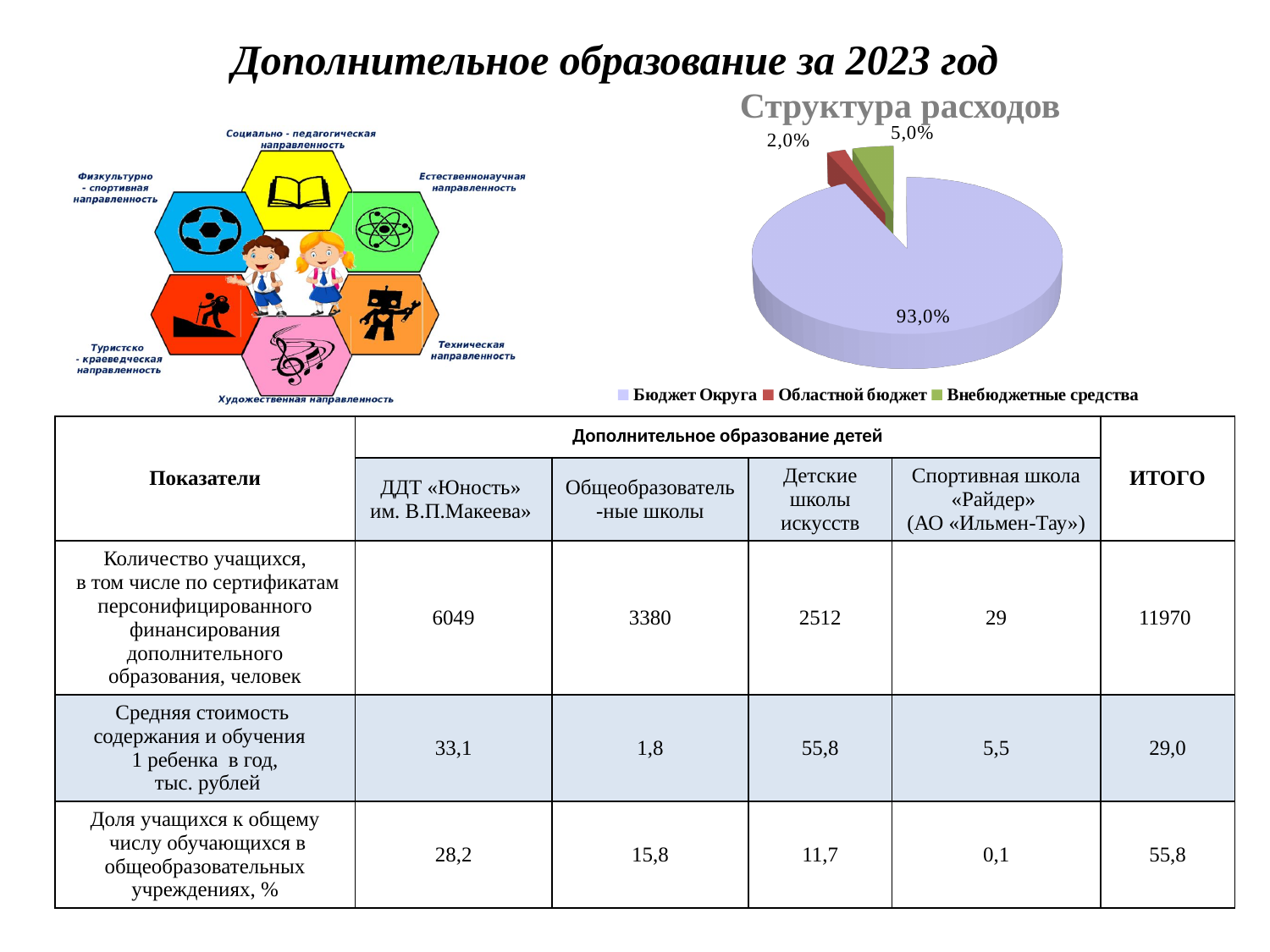
In the "Структура расходов" pie chart, what share does "Областной бюджет" have? 2,0% In the "Структура расходов" pie chart, what share does "Внебюджетные средства" have? 5,0% In the "Структура расходов" pie chart, which is larger: "Внебюджетные средства" or "Областной бюджет"? Внебюджетные средства In the "Структура расходов" pie chart, what is the difference in percentage points between "Внебюджетные средства" and "Областной бюджет"? 3,0 In the "Структура расходов" pie chart, what is the difference in percentage points between "Бюджет Округа" and "Внебюджетные средства"? 88,0 In the "Структура расходов" pie chart, which category has the smallest share? Областной бюджет How many slices does the "Структура расходов" pie chart have? 3 How many entries does the legend of the "Структура расходов" pie chart list? 3 In the "Структура расходов" pie chart, what share does "Бюджет Округа" have? 93,0% What is the title of the pie chart on the slide? Структура расходов In the "Структура расходов" pie chart, which category has the largest share? Бюджет Округа What kind of chart is the "Структура расходов" chart? pie chart